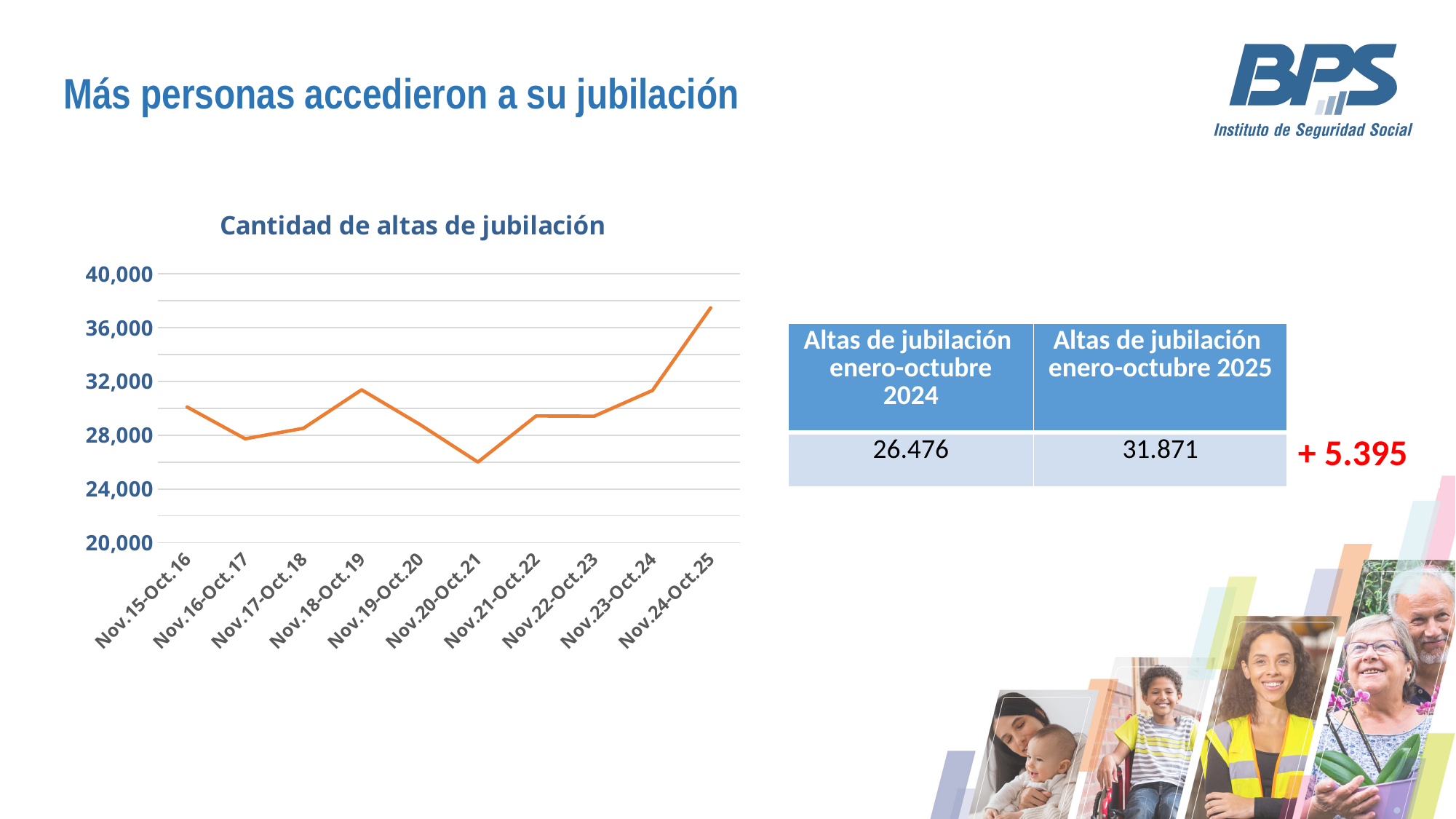
How many periods are plotted along the x axis of the chart? 10 What kind of chart is shown on the slide? line chart Do the values rise or fall from Nov.21-Oct.22 to Nov.24-Oct.25? rise Is the value for Nov.15-Oct.16 greater or less than 32,000? less What colour is the line in the chart? orange Which period has the lowest value in the chart? Nov.20-Oct.21 Is the value for Nov.24-Oct.25 greater or less than 36,000? greater What is the title of the chart? Cantidad de altas de jubilación Which period has the highest value in the chart? Nov.24-Oct.25 Is the value for Nov.20-Oct.21 greater or less than 28,000? less Which is larger, the value for Nov.18-Oct.19 or the value for Nov.20-Oct.21? Nov.18-Oct.19